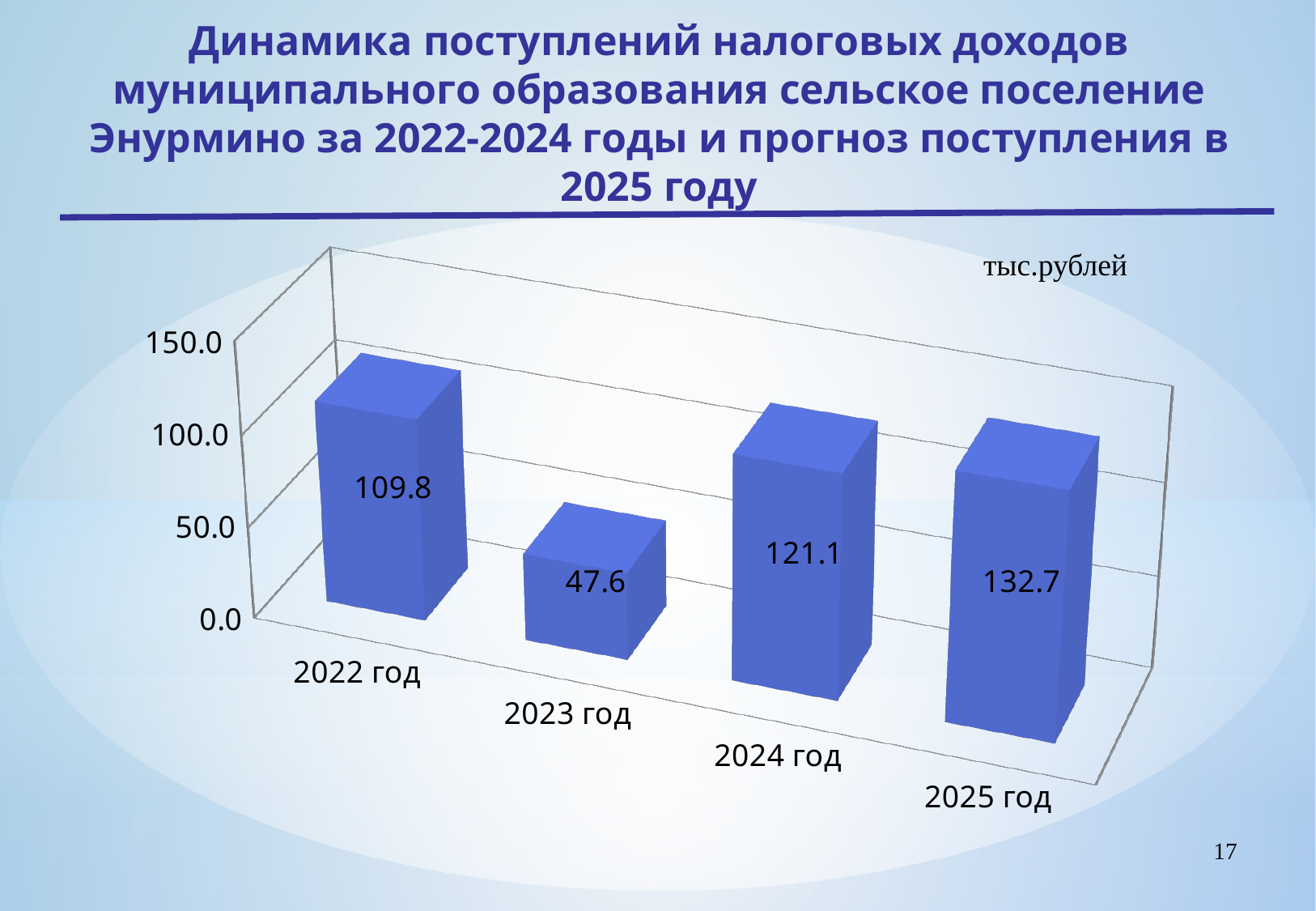
What is the value for 2025 год? 132.7 What is the value for 2024 год? 121.1 What kind of chart is shown on the slide? bar chart Which year has the highest value? 2025 год What is the difference between the values for 2022 год and 2023 год? 62.2 Which is larger, the value for 2022 год or the value for 2024 год? 2024 год Is the value for 2023 год greater or less than 50.0? less How many years are shown on the chart? 4 What is the value for 2023 год? 47.6 Which year has the lowest value? 2023 год What is the difference between the values for 2025 год and 2024 год? 11.6 What is the value for 2022 год? 109.8